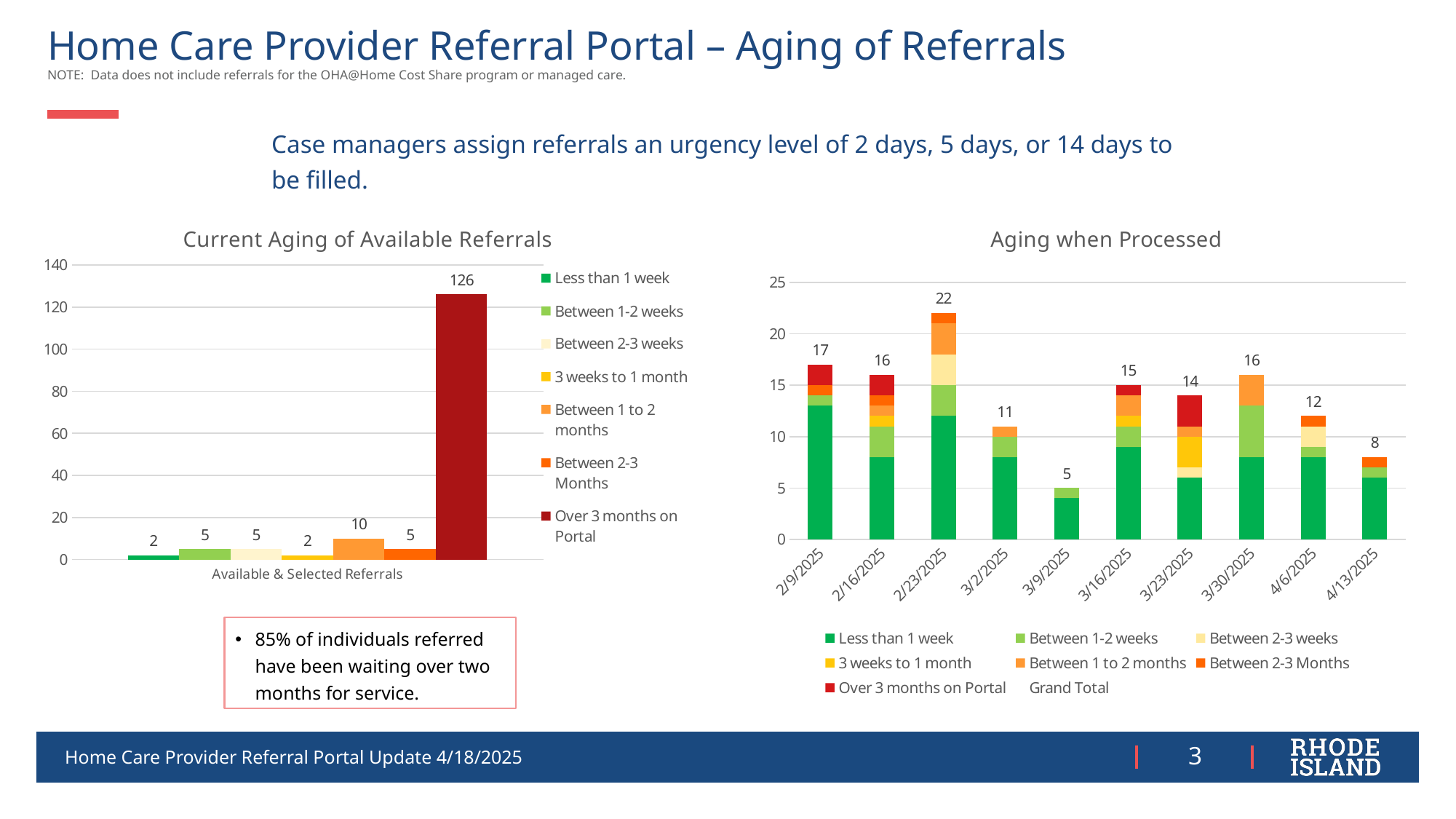
In the 'Aging when Processed' chart, is the 'Less than 1 week' value for 2/9/2025 greater or less than 10? greater In the 'Current Aging of Available Referrals' chart, what is the value for 'Between 1 to 2 months'? 10 How many series does the legend of the 'Current Aging of Available Referrals' chart list? 7 In the 'Aging when Processed' chart, which date has the highest total? 2/23/2025 In the 'Aging when Processed' chart, which date has the lowest total? 3/9/2025 How many dates are shown on the x axis of the 'Aging when Processed' chart? 10 What kind of chart is the 'Aging when Processed' chart? Stacked bar chart In the 'Current Aging of Available Referrals' chart, which series has the highest value? Over 3 months on Portal In the 'Current Aging of Available Referrals' chart, what is the difference between the 'Over 3 months on Portal' value and the 'Between 1 to 2 months' value? 116 In the 'Aging when Processed' chart, what is the total for 2/23/2025? 22 In the 'Current Aging of Available Referrals' chart, what is the value for 'Over 3 months on Portal'? 126 In the 'Aging when Processed' chart, what is the difference between the totals for 2/9/2025 and 4/13/2025? 9